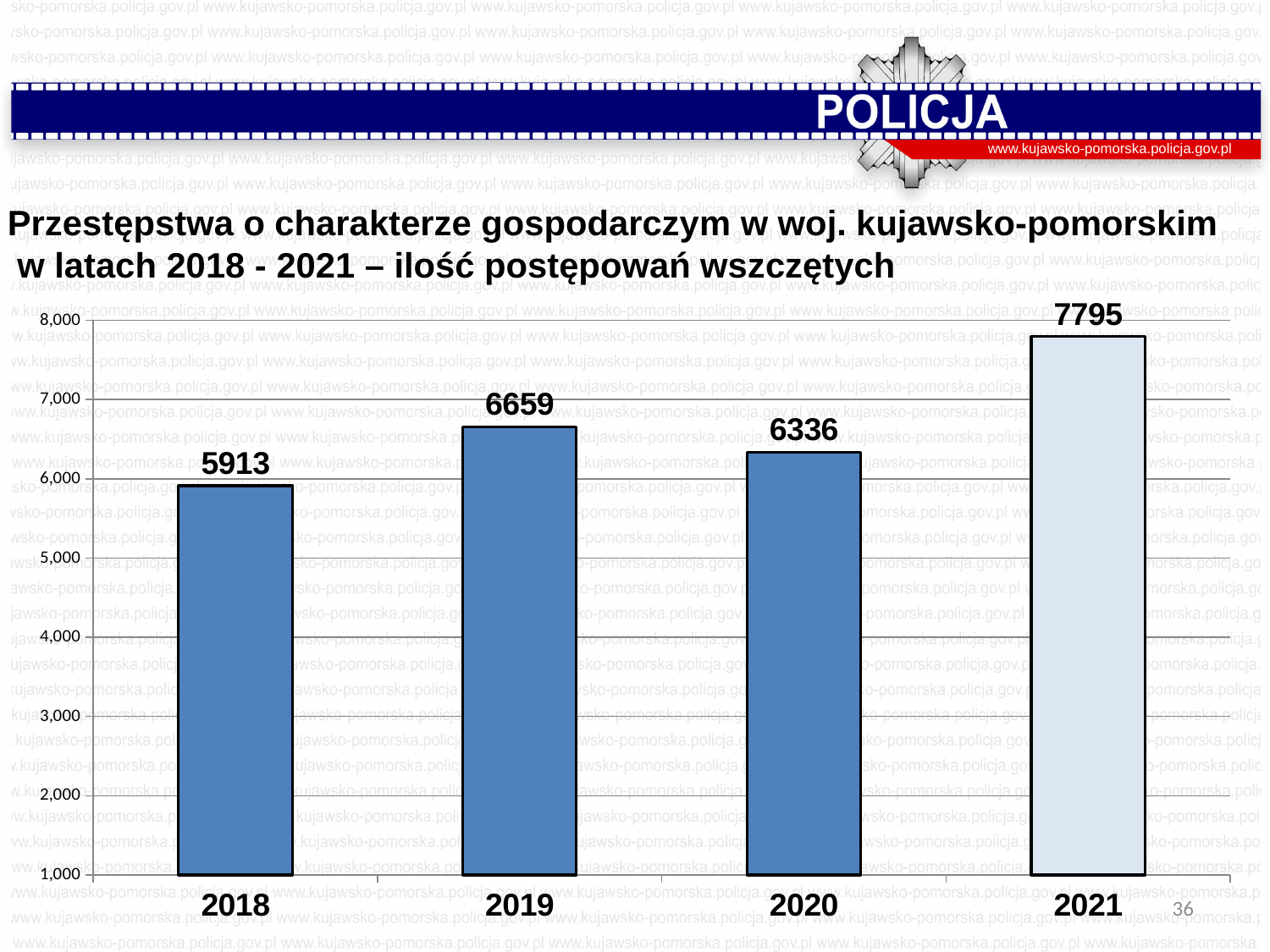
What kind of chart is shown on the slide? bar chart What is the value for 2021? 7795 What is the value for 2020? 6336 What is the difference between the values for 2019 and 2020? 323 Which year has the highest value? 2021 Which is larger, the value for 2019 or the value for 2020? 2019 How many years are shown on the x axis? 4 What is the value for 2018? 5913 Is the value for 2020 greater or less than 7,000? less What is the difference between the values for 2021 and 2018? 1882 Which year has the lowest value? 2018 What is the value for 2019? 6659